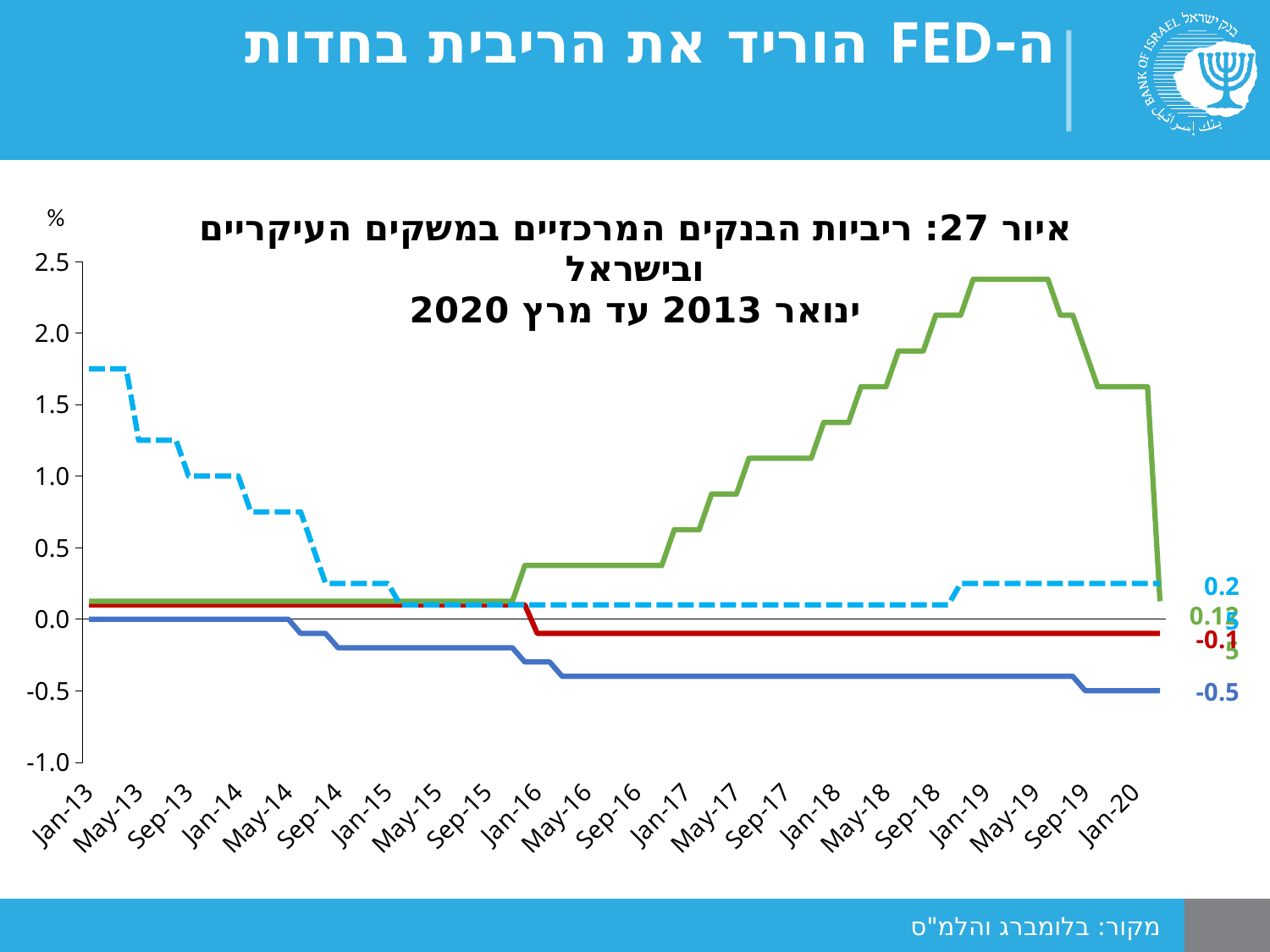
How many lines are plotted on the chart? 4 Which line has the lowest value at the right end of the chart? the solid dark-blue line What figure number is given in the chart title? 27 Does the dashed light-blue line rise or fall between Jan-13 and Jan-15? fall What unit is shown at the top of the vertical axis? % What kind of chart is shown on the slide? line chart What is the final value labelled for the red line at the right end of the chart? -0.1 At the right end of the chart, which is larger: the red line's value or the solid dark-blue line's value? the red line's value What is the final value labelled for the dashed light-blue line at the right end of the chart? 0.25 What is the final value labelled for the solid dark-blue line at the right end of the chart? -0.5 Is the value of the dashed light-blue line at Jan-13 greater or less than 1.5? greater Is the value of the green line around May-19 greater or less than 2.0? greater